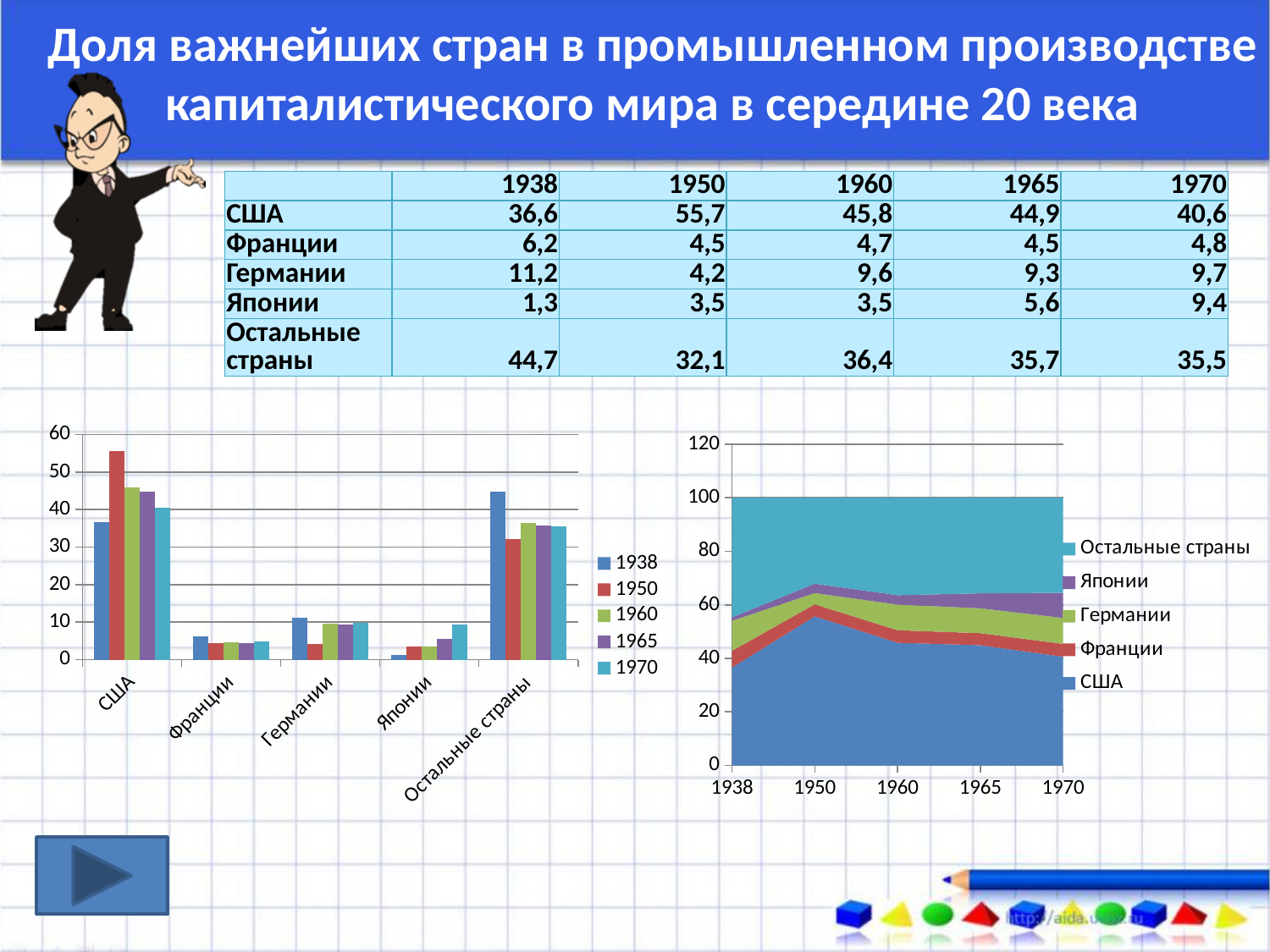
In the bar chart on the left, is the 1938 value for Остальные страны greater or less than 40? greater In the bar chart on the left, what is the difference between the 1950 and 1938 values for США? 19,1 In the bar chart on the left, how many categories are shown on the x axis? 5 In the bar chart on the left, which category has the lowest value for 1938? Японии What kind of chart is the chart on the left of the slide? bar chart In the bar chart on the left, what is the value for Японии in 1970? 9,4 In the bar chart on the left, which category has the highest value for 1950? США In the bar chart on the left, how many series does the legend list? 5 In the bar chart on the left, what is the value for США in 1950? 55,7 In the bar chart on the left, do the values for Японии rise or fall from 1938 to 1970? rise What kind of chart is the chart on the right of the slide? stacked area chart In the bar chart on the left, which is larger: the 1938 value for Германии or the 1938 value for Франции? Германии